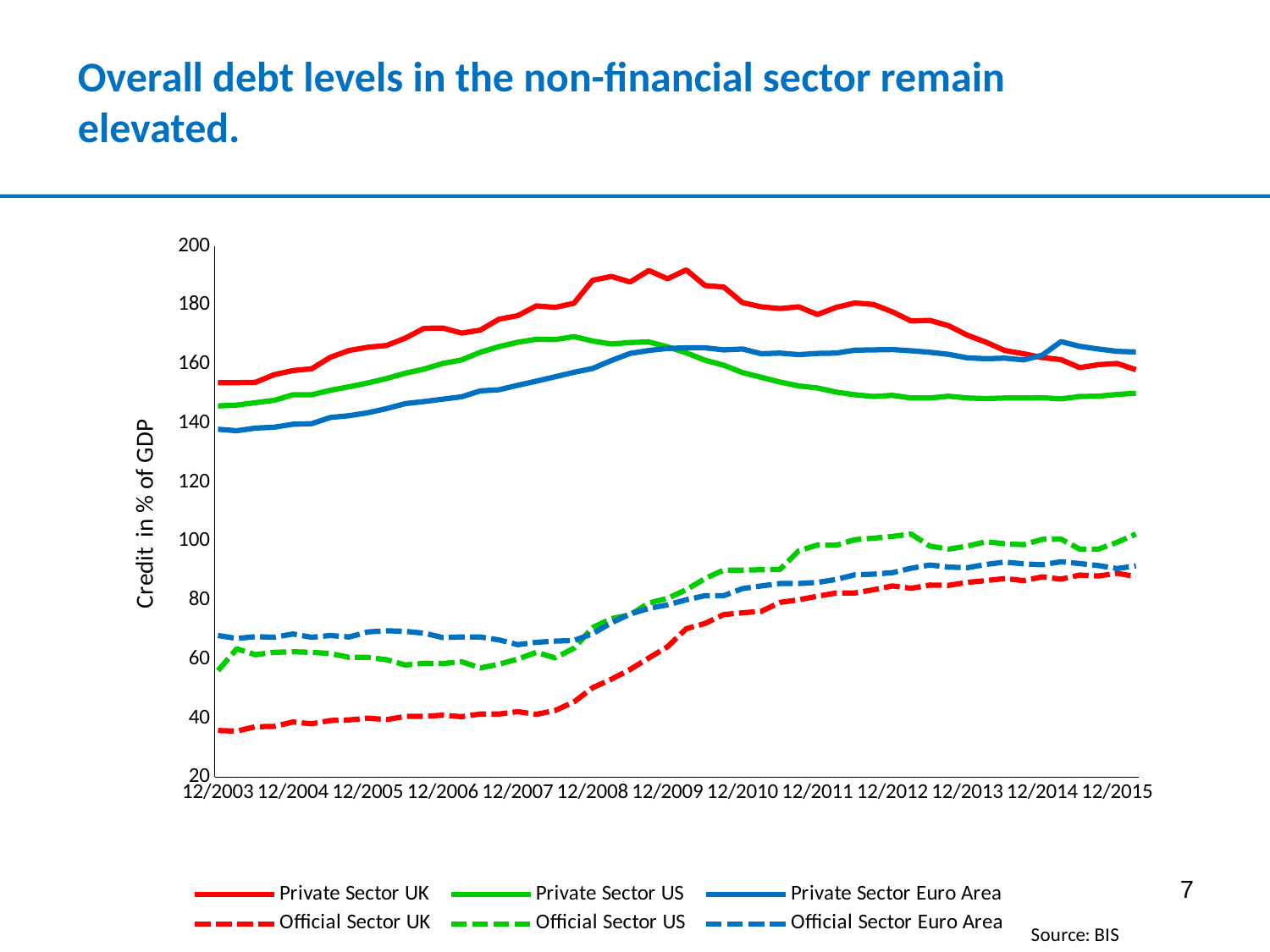
Which series has the lowest value at 12/2003? Official Sector UK Does the Private Sector US series rise or fall from 12/2008 to 12/2015? fall Is the value for Official Sector UK at 12/2003 greater or less than 40? less Which series has the highest value at 12/2009? Private Sector UK Does the Official Sector UK series rise or fall from 12/2003 to 12/2015? rise What is the label of the y axis? Credit in % of GDP What kind of chart is shown on the slide? line chart Is the value for Private Sector US at 12/2015 greater or less than 160? less How many series does the legend list? 6 Is the value for Private Sector UK at 12/2009 greater or less than 180? greater At 12/2015, which is larger: Private Sector Euro Area or Private Sector US? Private Sector Euro Area How many dates are labelled on the x axis? 13